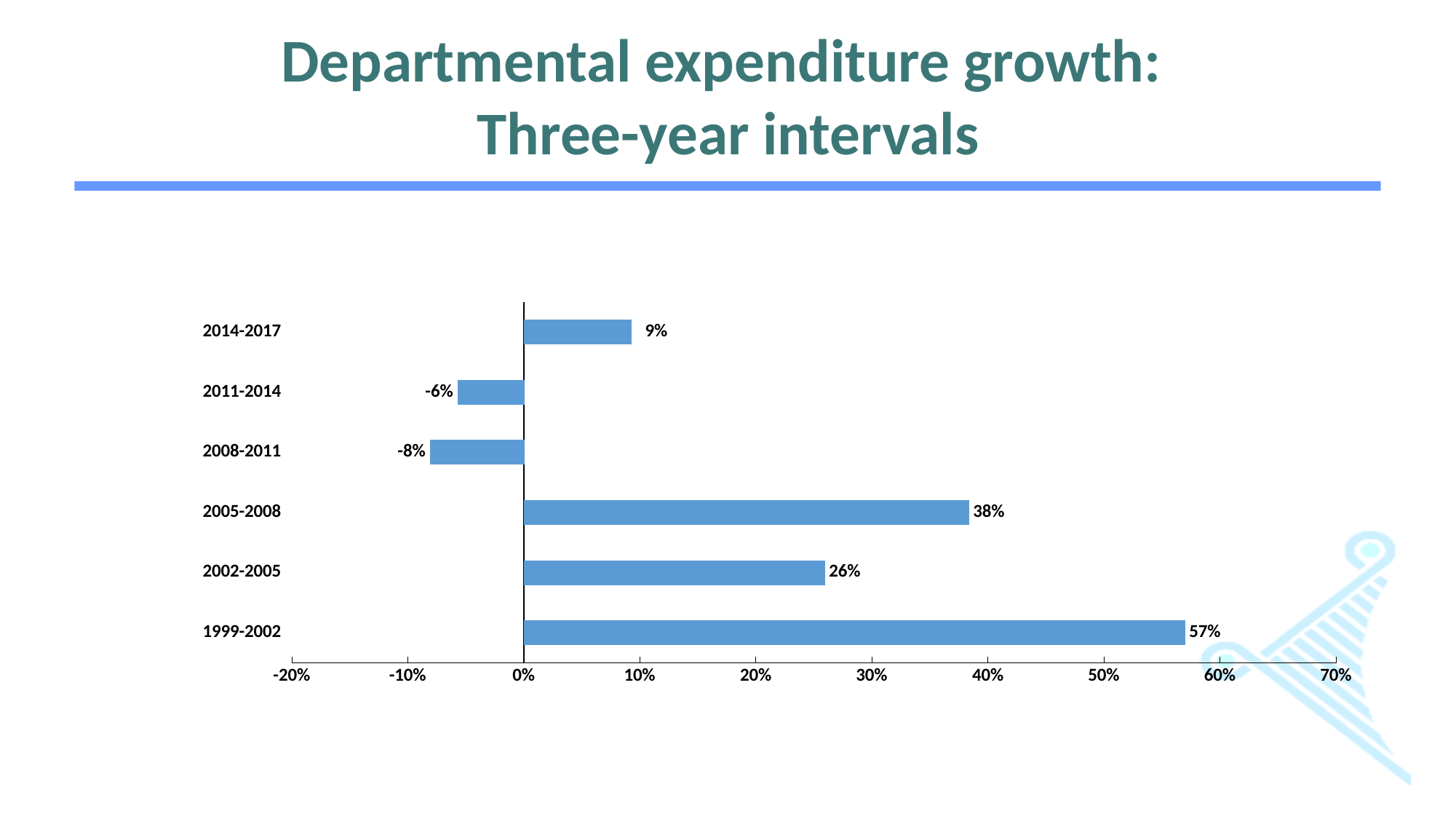
Which three-year interval has the lowest expenditure growth? 2008-2011 Which three-year interval has the highest expenditure growth? 1999-2002 What is the difference between the growth for 2005-2008 and 2002-2005? 12% How many intervals show negative expenditure growth? 2 Which interval has higher expenditure growth, 2002-2005 or 2005-2008? 2005-2008 How many three-year intervals are shown in the chart? 6 What kind of chart is shown on the slide? Bar chart What is the departmental expenditure growth for 2008-2011? -8% What is the departmental expenditure growth for 2014-2017? 9% What is the difference between the growth for 1999-2002 and 2005-2008? 19% Is the value for 2005-2008 greater or less than 30%? greater What is the departmental expenditure growth for 1999-2002? 57%